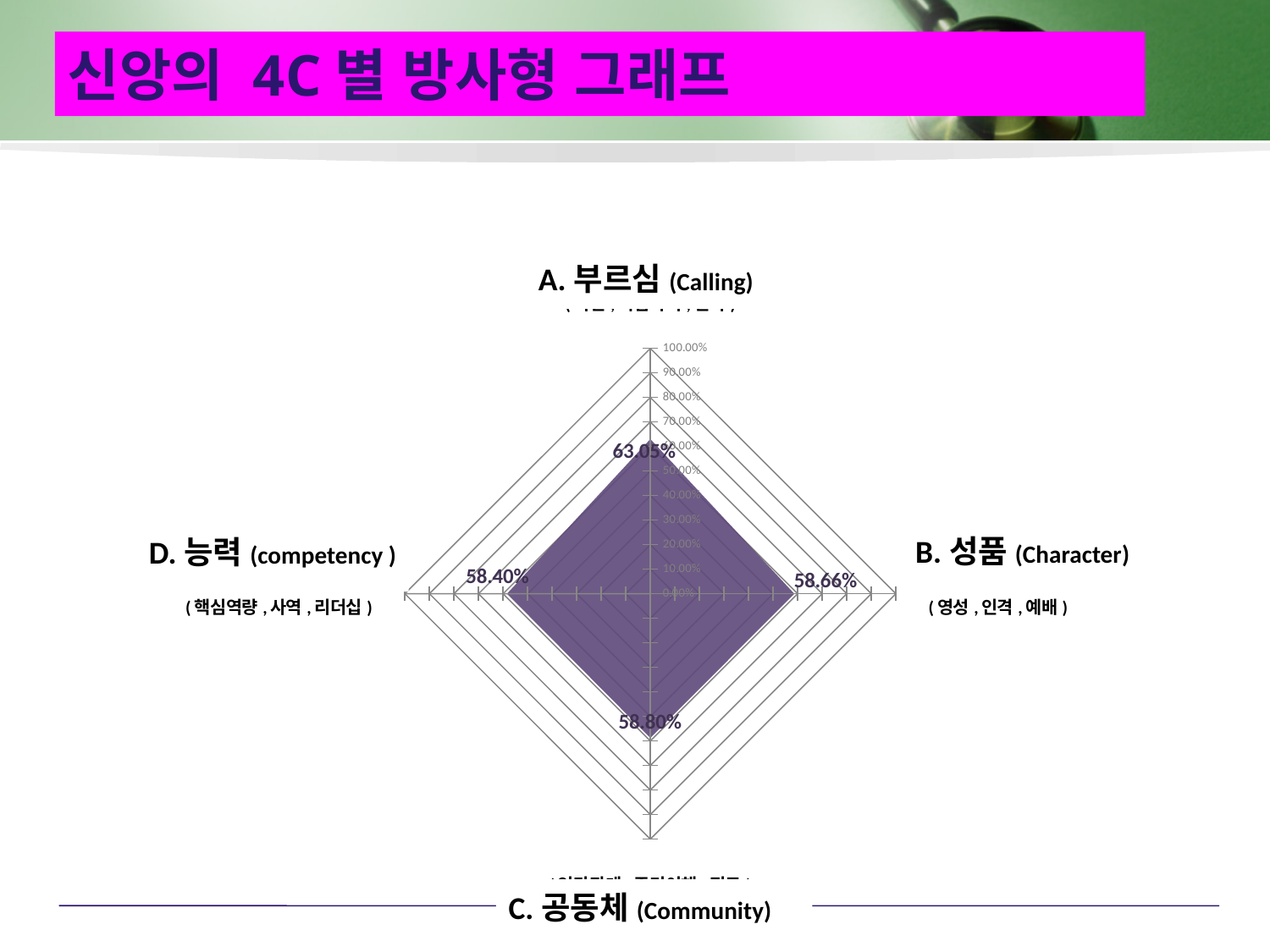
Which is larger, the value for A. 부르심 (Calling) or the value for C. 공동체 (Community)? A. 부르심 (Calling) What kind of chart is shown on the slide? Radar chart How many categories (axes) does the radar chart have? 4 What is the value for B. 성품 (Character)? 58.66% What is the value for D. 능력 (competency)? 58.40% What is the difference between the values for A. 부르심 (Calling) and B. 성품 (Character)? 4.39% What is the value for C. 공동체 (Community)? 58.80% Which of the four categories has the lowest value? D. 능력 (competency) Which of the four categories has the highest value? A. 부르심 (Calling) Is the value for A. 부르심 (Calling) greater or less than 60.00%? greater What is the difference between the values for A. 부르심 (Calling) and D. 능력 (competency)? 4.65% What is the value for A. 부르심 (Calling) on the radar chart? 63.05%